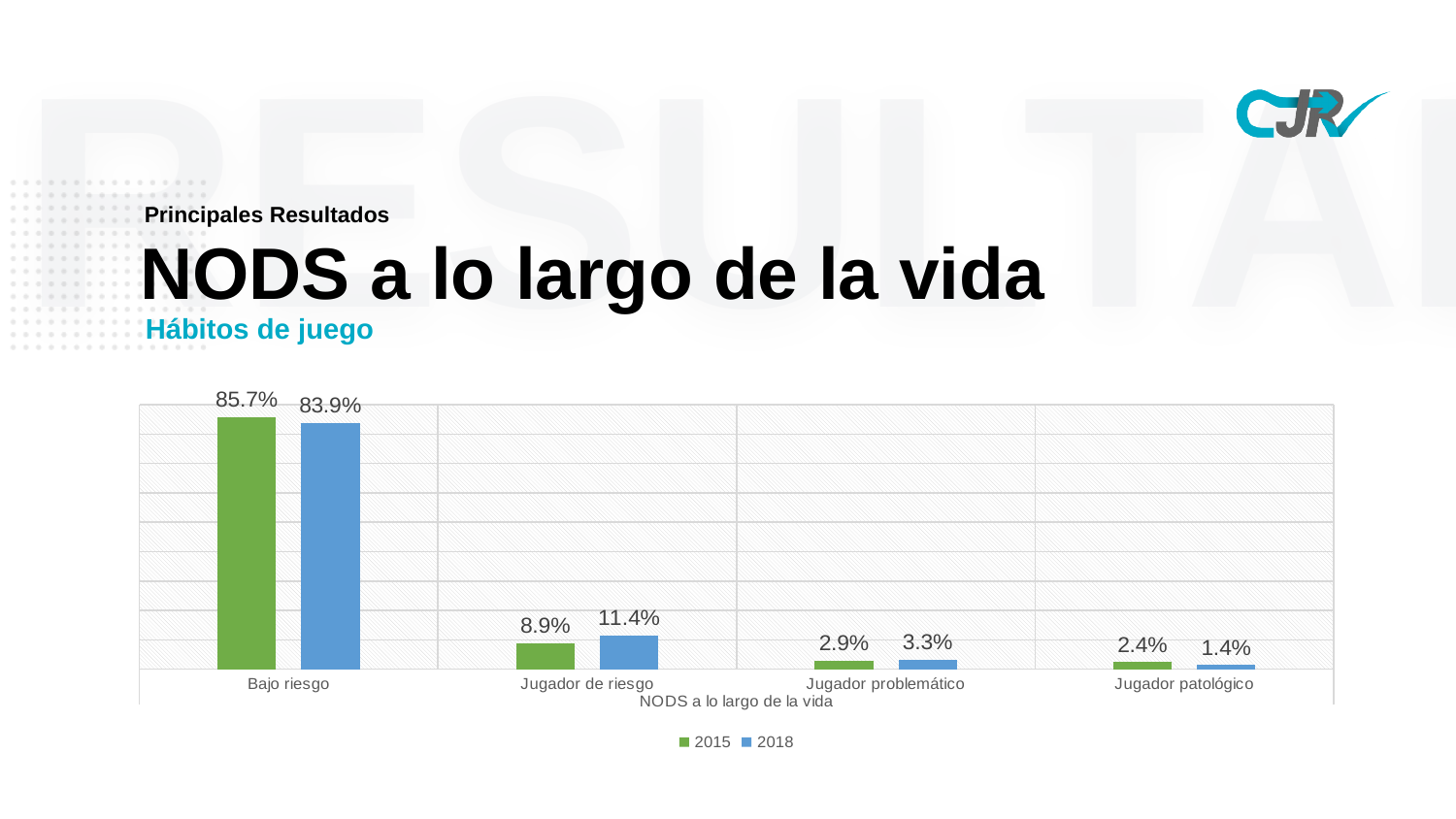
What is the difference between the 2015 and 2018 values for Jugador de riesgo? 2.5% What is the value for Jugador problemático in 2015? 2.9% What is the value for Jugador de riesgo in 2018? 11.4% What is the difference between the 2015 and 2018 values for Bajo riesgo? 1.8% What kind of chart is shown on the slide? Bar chart Which is larger for Jugador problemático, the 2015 value or the 2018 value? 2018 How many categories are shown on the x axis? 4 What is the value for Jugador patológico in 2018? 1.4% Which category has the highest value in 2018? Bajo riesgo Which category has the lowest value in 2015? Jugador patológico What is the value for Bajo riesgo in 2015? 85.7% How many series does the legend list? 2